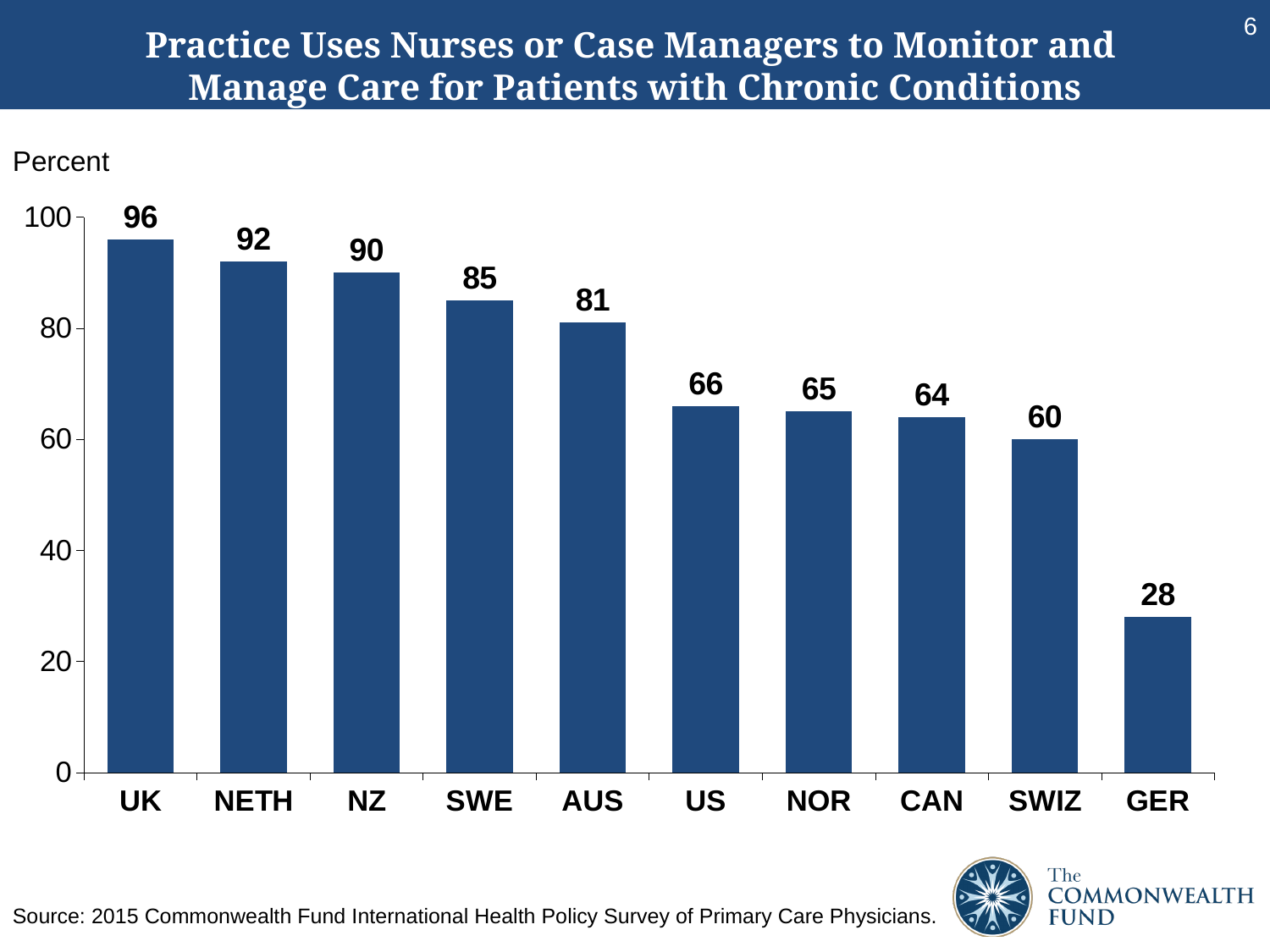
Which is larger, the value for SWE or the value for CAN? SWE What is the difference between the values for AUS and US? 15 What is the value for SWE? 85 Which country has the lowest value? GER Which country has the highest value? UK Do the values rise or fall from left to right along the x axis? fall What kind of chart is shown on the slide? bar chart What is the difference between the values for NETH and NZ? 2 What is the value for the UK? 96 How many countries are shown on the chart? 10 What is the value for GER? 28 Is the value for SWIZ greater or less than 80? less